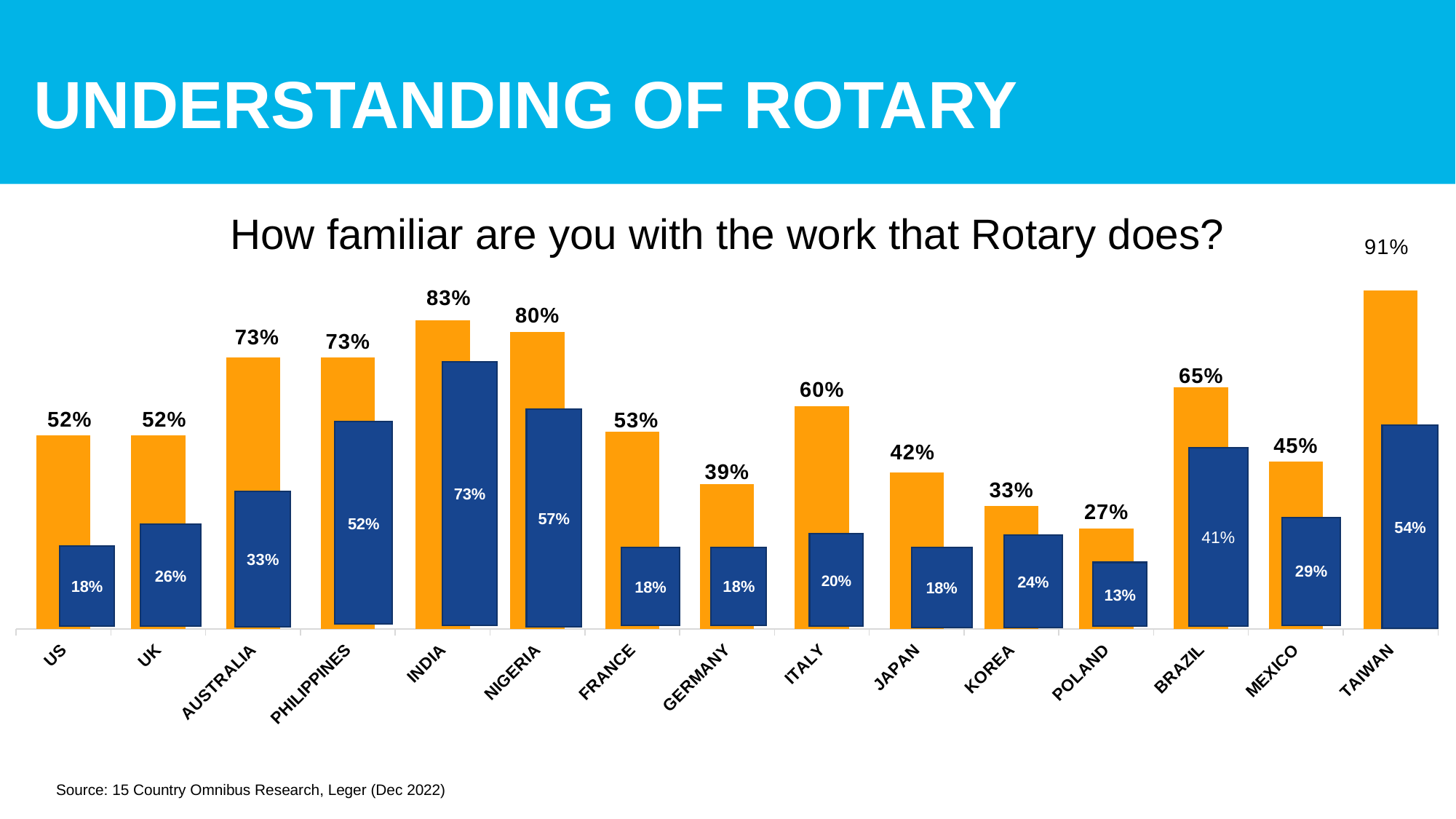
What is the difference between the orange bar and the blue bar for Nigeria? 23% Which country has the lowest blue bar? Poland Which country has the highest orange bar? Taiwan What is the title of the chart? How familiar are you with the work that Rotary does? What is the value of the orange bar for Poland? 27% Which is larger, the orange bar for Italy or the orange bar for Brazil? Brazil What is the difference between the orange bars for Taiwan and the US? 39% What is the value of the orange bar for India? 83% What is the value of the blue bar for Brazil? 41% Which country has the highest blue bar? India How many countries are shown on the x axis? 15 What type of chart is shown on the slide? Bar chart